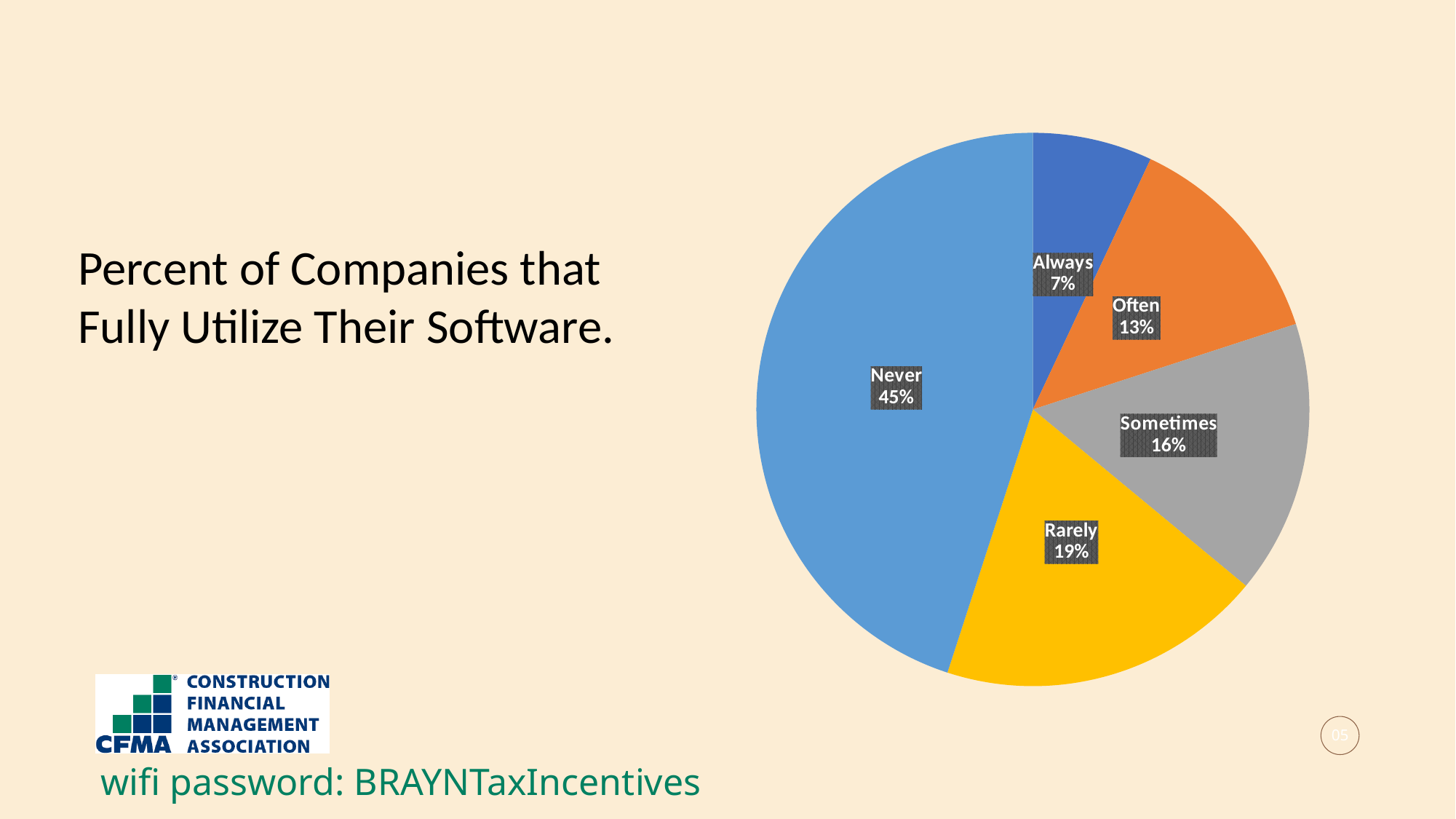
What colour is the "Rarely" slice? yellow What is the title text shown to the left of the chart? Percent of Companies that Fully Utilize Their Software. What is the difference in percentage points between "Rarely" and "Often"? 6 What is the combined share of "Always" and "Often"? 20% Which category has the largest share of the pie? Never What percentage of companies are labelled "Never"? 45% What is the value for the "Sometimes" slice? 16% What kind of chart is shown on the slide? pie chart Which is larger, the "Sometimes" slice or the "Often" slice? Sometimes Which category has the smallest share of the pie? Always What is the value for the "Always" slice? 7% How many slices does the pie chart have? 5